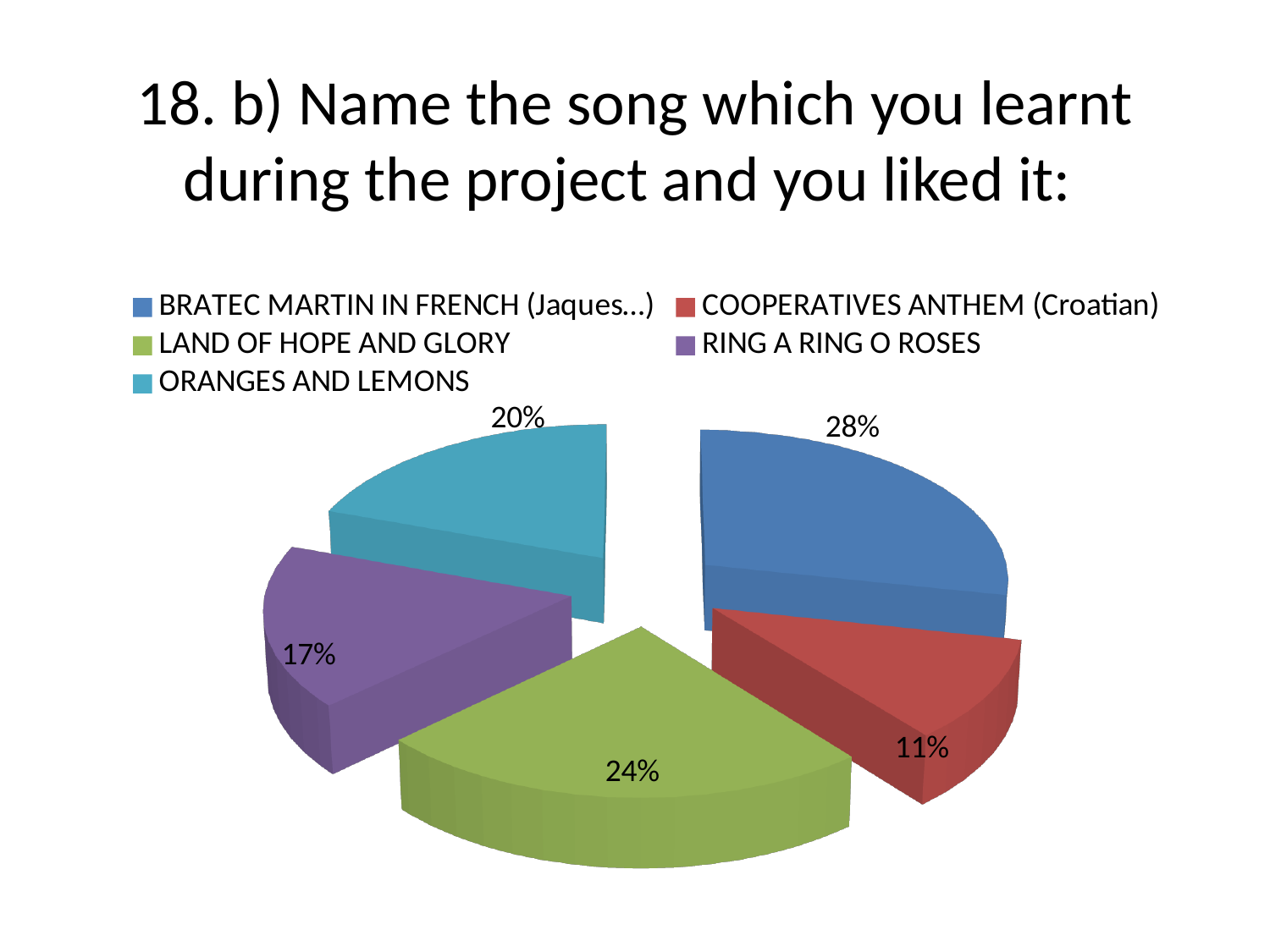
What percentage of the pie is for COOPERATIVES ANTHEM (Croatian)? 11% What kind of chart is shown on the slide? pie chart What is the difference in percentage points between LAND OF HOPE AND GLORY and RING A RING O ROSES? 7 Which song has the largest share of the pie? BRATEC MARTIN IN FRENCH (Jaques...) What percentage of the pie is for RING A RING O ROSES? 17% How many slices does the pie chart have? 5 What colour is the slice for LAND OF HOPE AND GLORY? green What percentage of the pie is for LAND OF HOPE AND GLORY? 24% Which song has the smallest share of the pie? COOPERATIVES ANTHEM (Croatian) Which has a larger share, ORANGES AND LEMONS or COOPERATIVES ANTHEM (Croatian)? ORANGES AND LEMONS What percentage of the pie is for ORANGES AND LEMONS? 20% What percentage of the pie is for BRATEC MARTIN IN FRENCH (Jaques...)? 28%